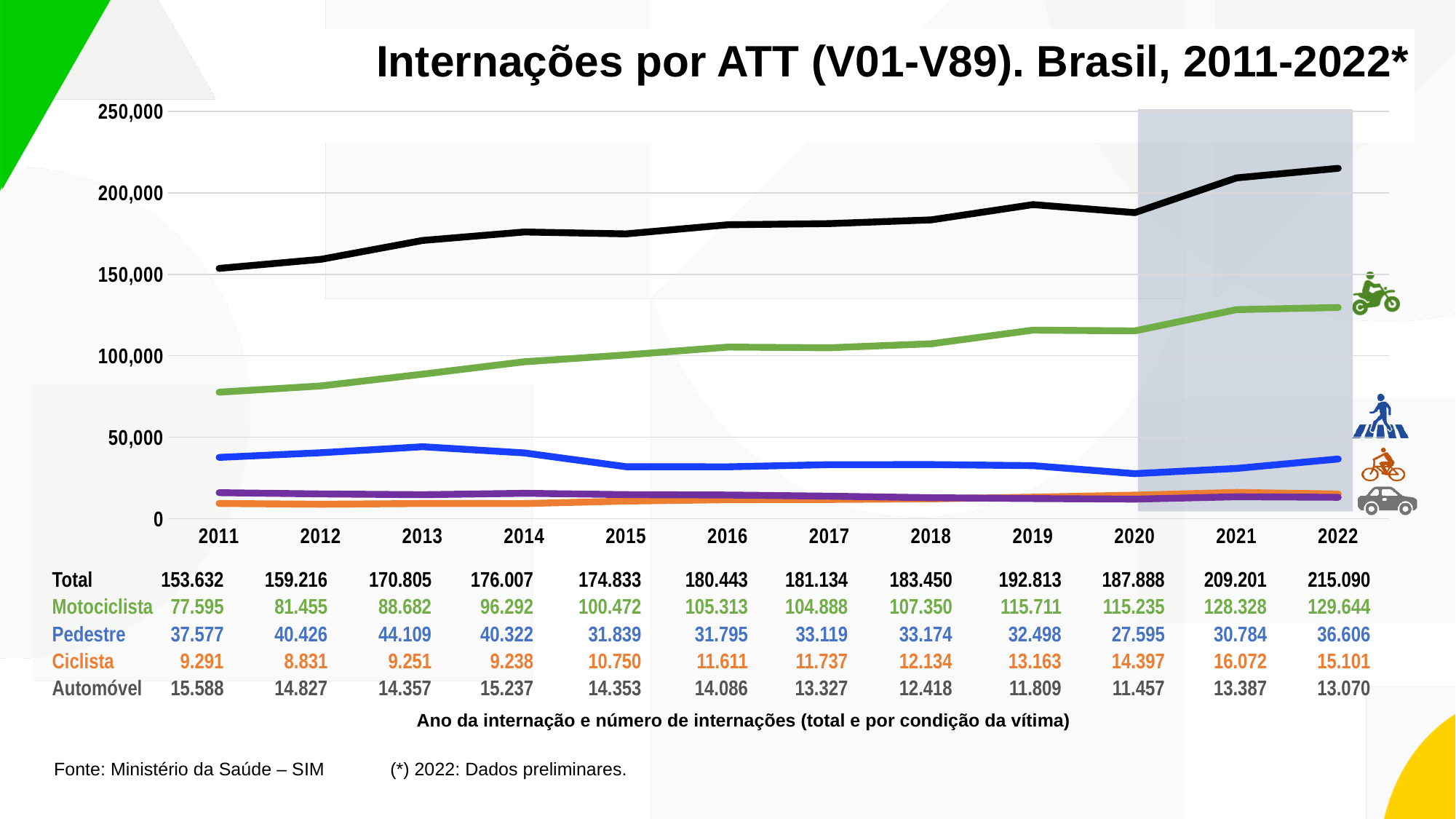
How many years are plotted along the x axis? 12 In 2022, which is larger: the Ciclista value or the Automóvel value? Ciclista Does the Motociclista series generally rise or fall from 2011 to 2022? rise What is the Motociclista value for 2015? 100.472 What kind of chart is shown on the slide? line chart What is the Automóvel value for 2011? 15.588 What is the Total value for 2022? 215.090 In which year is the Total value lowest? 2011 In which year is the Pedestre value highest? 2013 How many series are listed in the data table below the chart? 5 What is the difference between the Total value in 2022 and in 2011? 61.458 Is the Total value for 2019 greater or less than 200,000? less